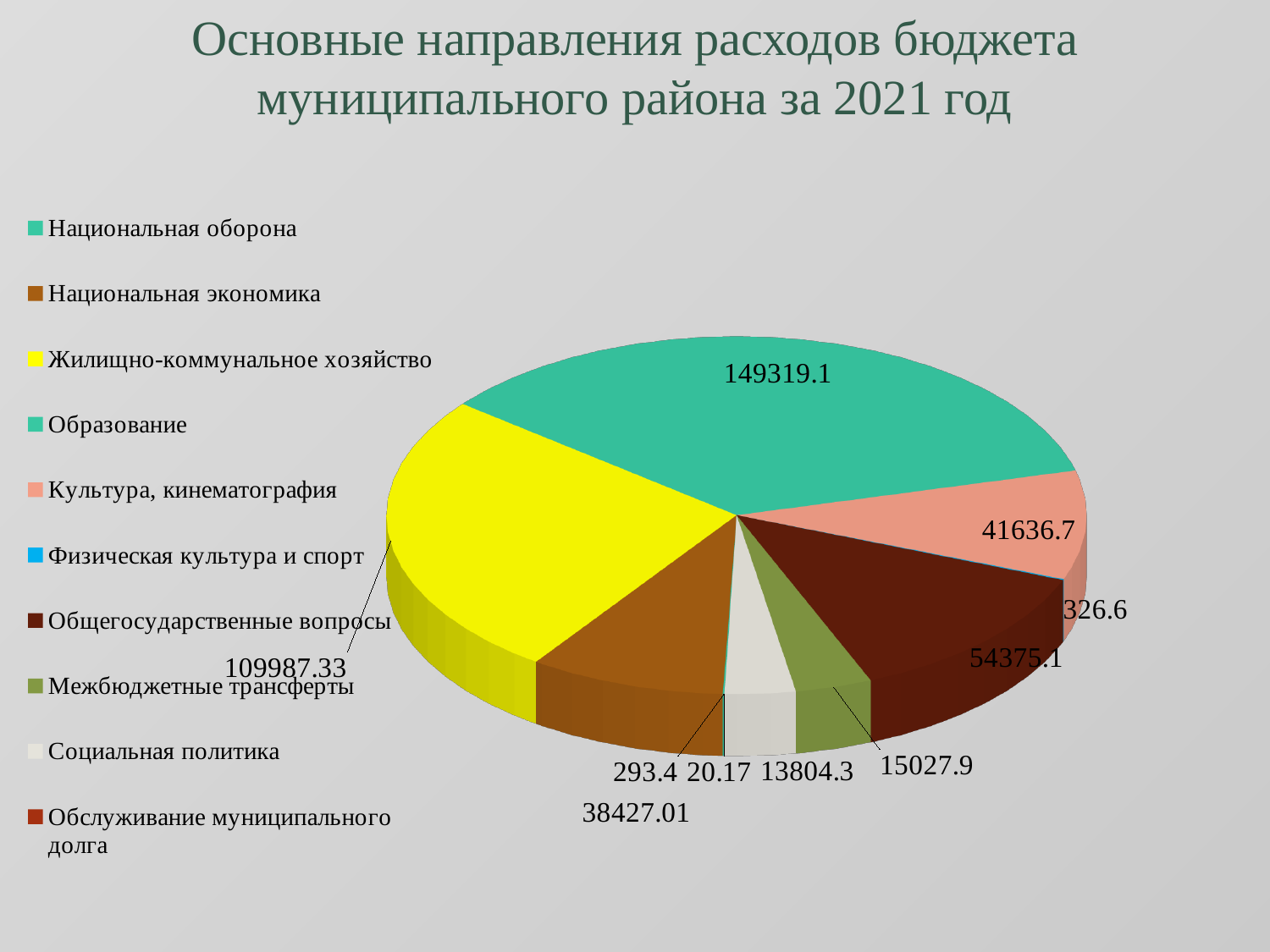
What is the title of the slide containing the pie chart? Основные направления расходов бюджета муниципального района за 2021 год What is the smallest data label value shown on the pie chart? 20.17 What is the difference between the values for Образование and Жилищно-коммунальное хозяйство? 39331.77 What is the difference between the values for Межбюджетные трансферты and Социальная политика? 1223.6 What is the value shown for Образование? 149319.1 Which category has the largest slice of the pie? Образование What is the value shown for Культура, кинематография? 41636.7 What is the value shown for Жилищно-коммунальное хозяйство? 109987.33 How many categories does the legend of the pie chart list? 10 What is the value shown for Общегосударственные вопросы? 54375.1 What kind of chart is shown on the slide? pie chart Which is larger: the value for Культура, кинематография or the value for Национальная экономика? Культура, кинематография